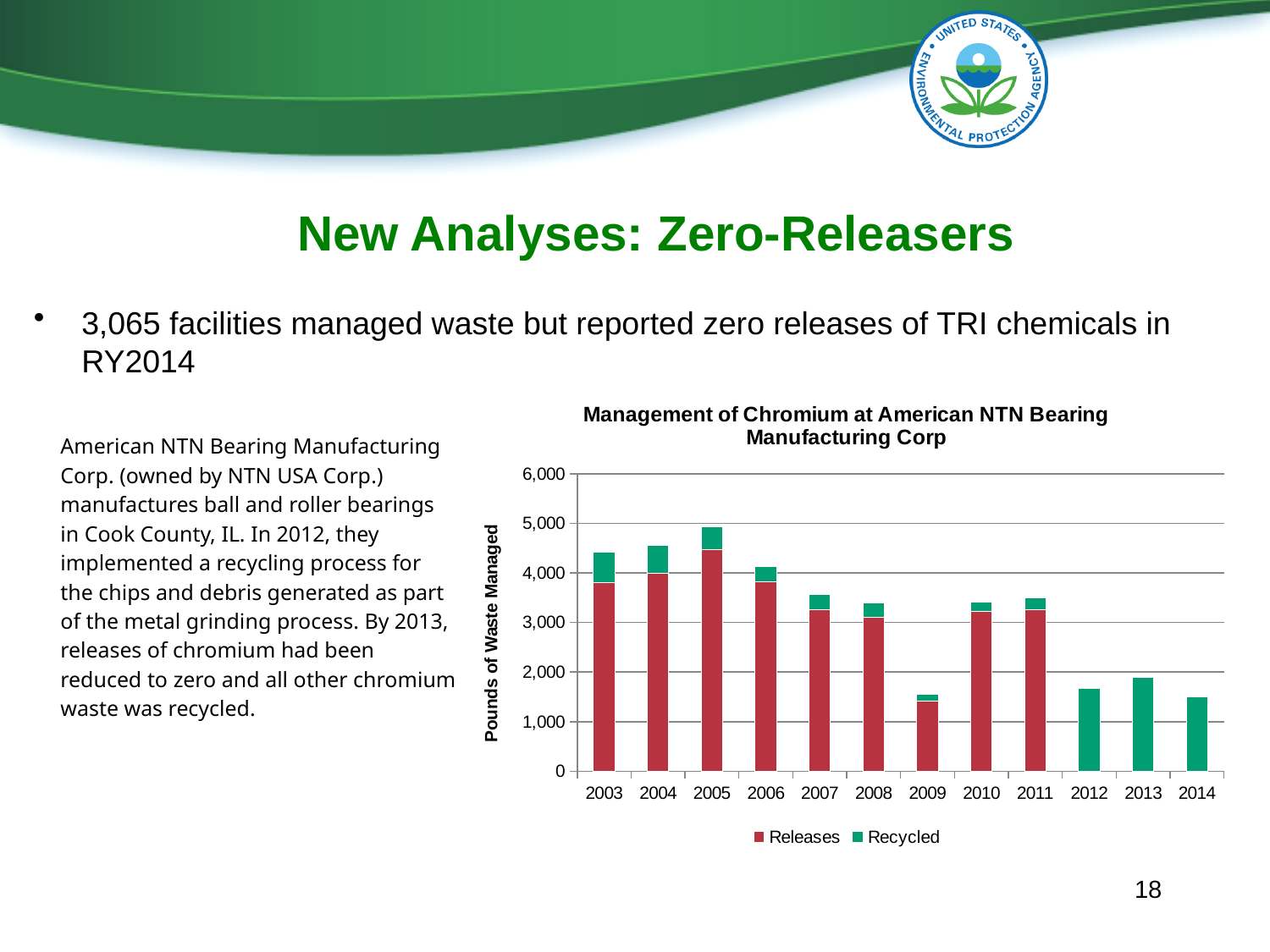
How many years are shown on the x axis of the chart? 12 Is the value for 2013 greater or less than 2,000? less Is the total value for 2009 greater or less than 2,000? less Which year has the highest total pounds of waste managed? 2005 Do the total pounds of waste managed generally rise or fall from 2003 to 2014? Fall Is the total value for 2003 greater or less than 4,000? greater What are the two series listed in the chart's legend? Releases and Recycled What is the title of the chart? Management of Chromium at American NTN Bearing Manufacturing Corp What kind of chart is shown on the slide? Stacked bar chart How many series does the chart's legend list? 2 Which is larger, the total for 2005 or the total for 2009? 2005